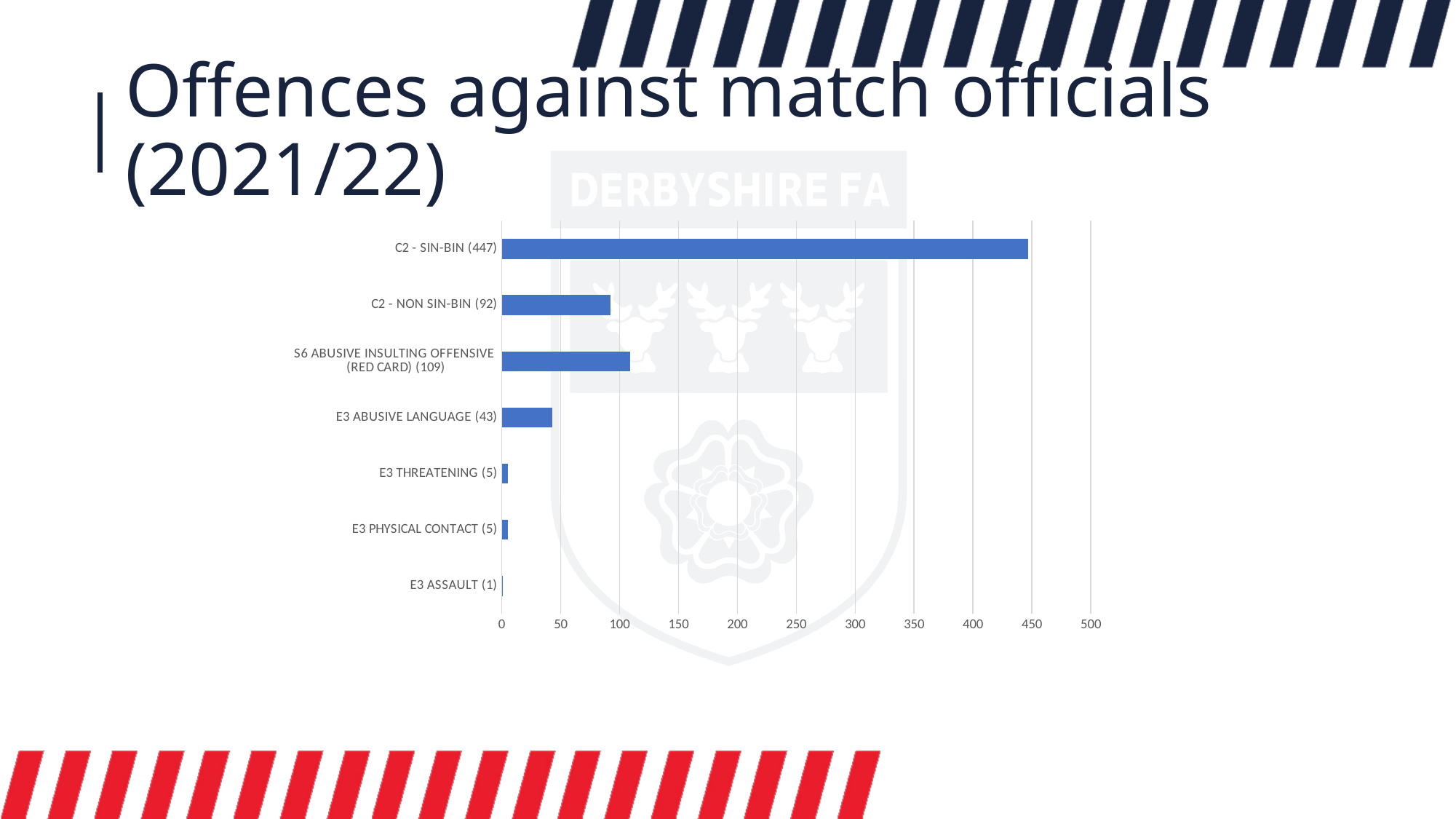
Which category has the highest value? C2 - SIN-BIN What is the title of the slide containing the chart? Offences against match officials (2021/22) Which is larger, the value for C2 - NON SIN-BIN or the value for S6 ABUSIVE INSULTING OFFENSIVE (RED CARD)? S6 ABUSIVE INSULTING OFFENSIVE (RED CARD) What is the value for C2 - SIN-BIN? 447 Which category has the lowest value? E3 ASSAULT How many categories are shown in the chart? 7 What is the difference between the values for C2 - SIN-BIN and C2 - NON SIN-BIN? 355 What is the value for E3 ASSAULT? 1 What is the value for S6 ABUSIVE INSULTING OFFENSIVE (RED CARD)? 109 Is the value for C2 - SIN-BIN greater or less than 400? greater What is the value for E3 ABUSIVE LANGUAGE? 43 What kind of chart is shown on the slide? bar chart